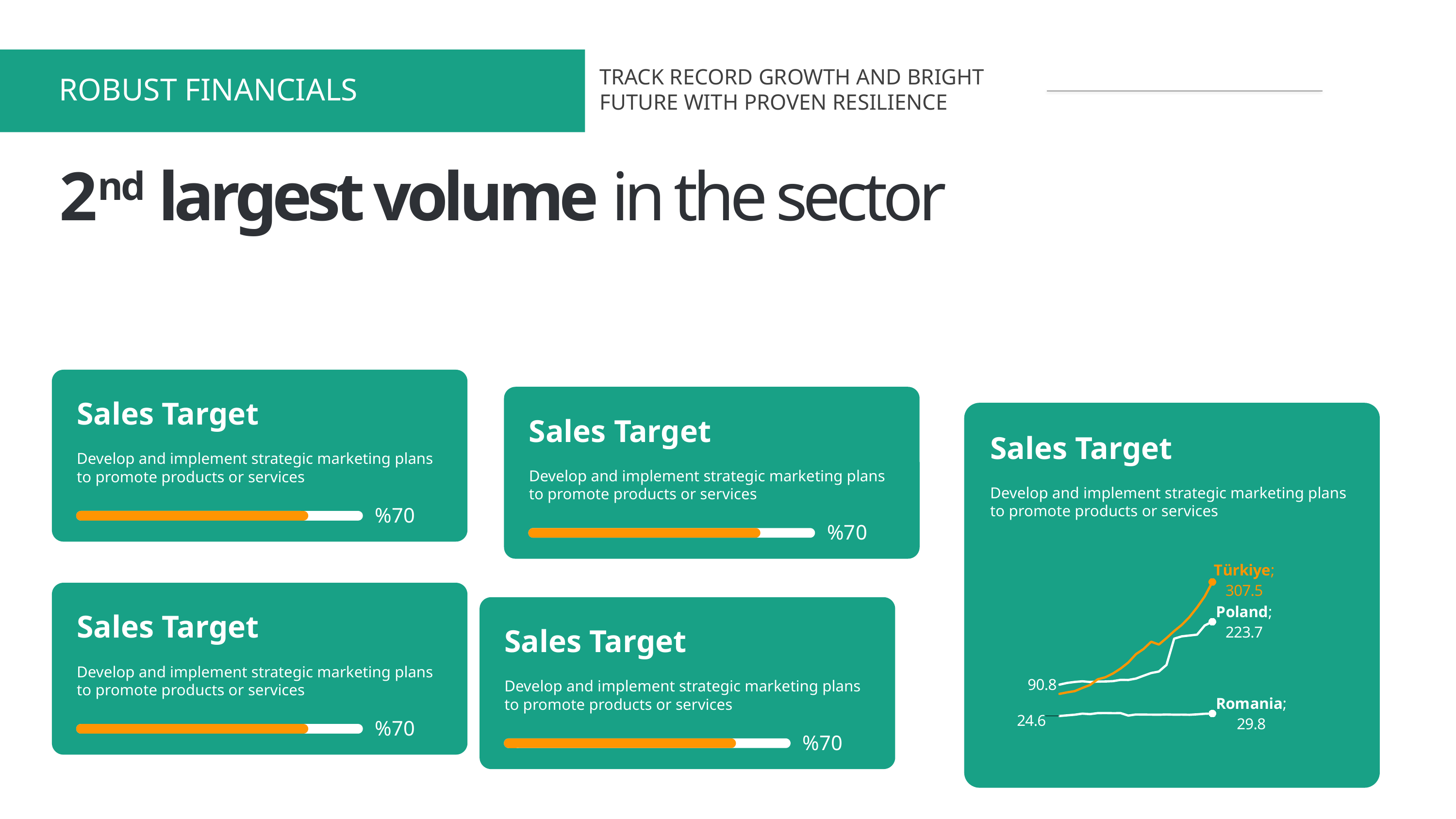
What kind of chart is shown in the right-hand Sales Target panel? line chart In the line chart, what is the final labelled value for Poland? 223.7 In the line chart, what is the final labelled value for Romania? 29.8 In the line chart, what is the difference between the final values of Türkiye and Poland? 83.8 In the line chart, what is the final labelled value for Türkiye? 307.5 In the line chart, which has the larger final value, Türkiye or Poland? Türkiye In the line chart, which series ends at the highest value? Türkiye How many series are plotted in the line chart on the right? 3 In the line chart, what is the difference between the final values of Poland and Romania? 193.9 In the line chart, does the Türkiye line rise or fall from left to right? rise In the line chart, what colour is the Türkiye line? orange In the line chart, which series ends at the lowest value? Romania